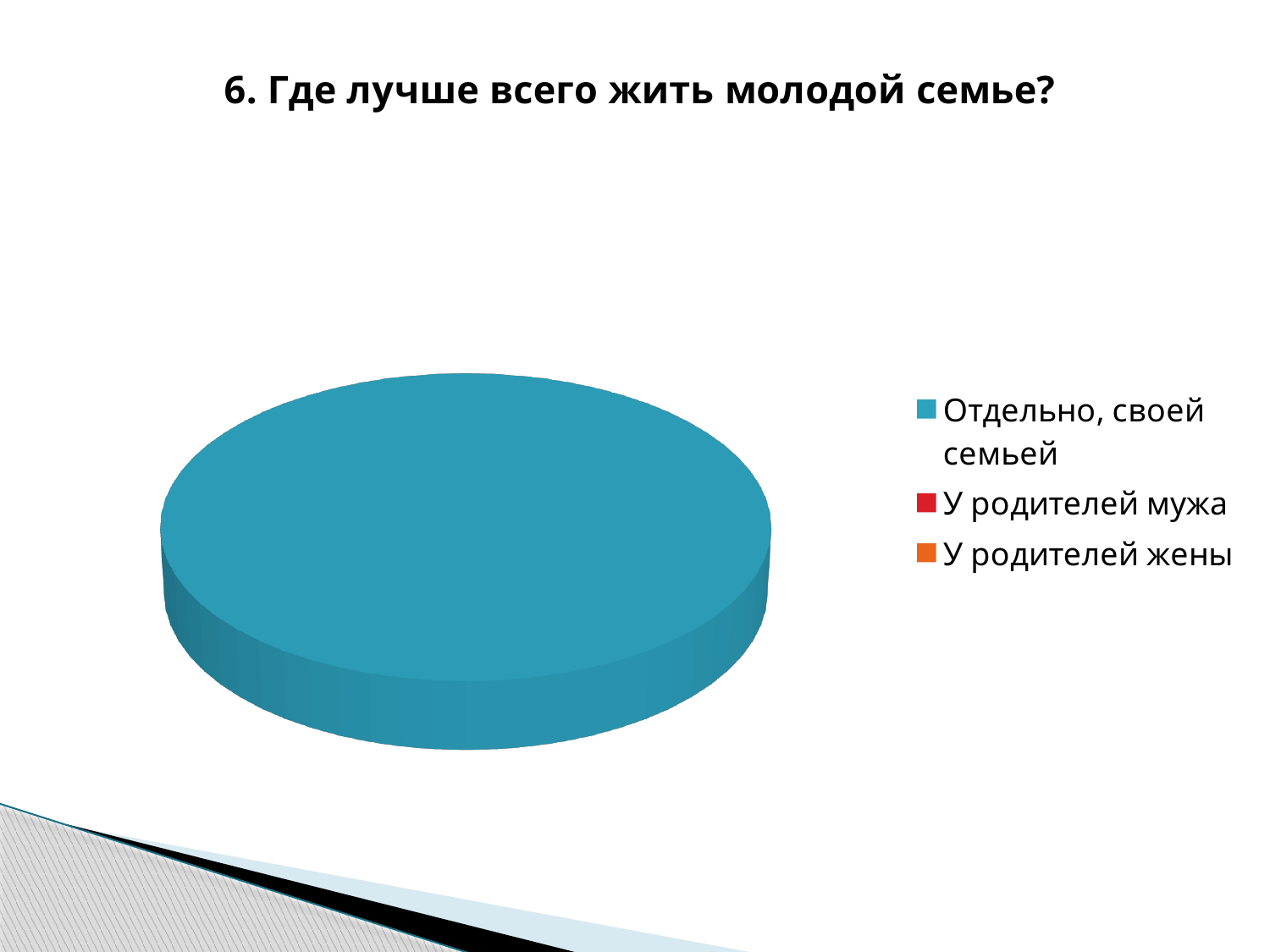
Which is larger: the share for "Отдельно, своей семьей" or the share for "У родителей жены"? Отдельно, своей семьей What kind of chart is shown on the slide? pie chart What is the title of the chart? 6. Где лучше всего жить молодой семье? Which is larger: the share for "Отдельно, своей семьей" or the share for "У родителей мужа"? Отдельно, своей семьей How many entries does the legend list? 3 Which category has the largest share of the pie? Отдельно, своей семьей What colour is the slice for "Отдельно, своей семьей"? blue